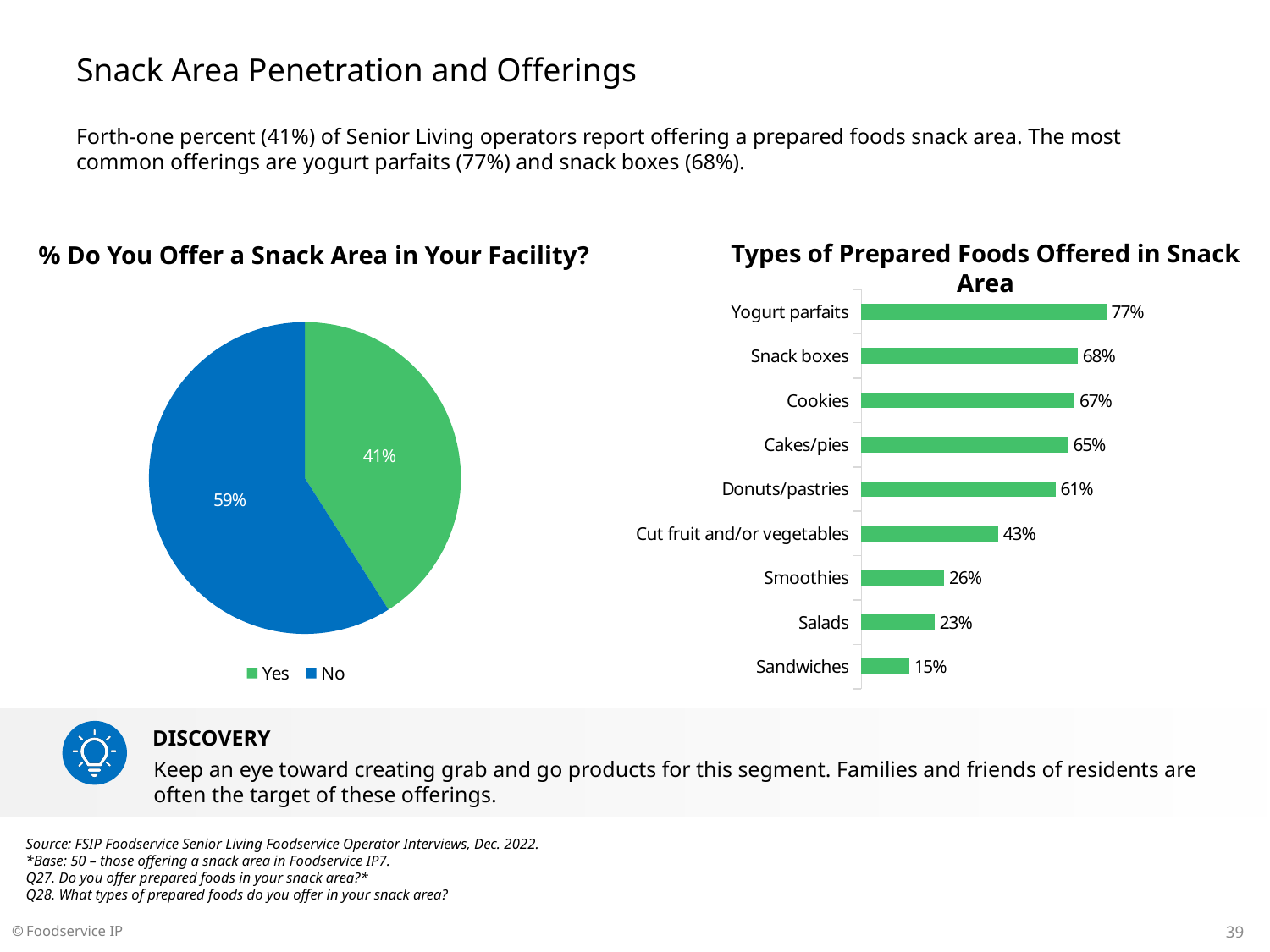
In the pie chart '% Do You Offer a Snack Area in Your Facility?', what share of respondents answered No? 59% In the chart 'Types of Prepared Foods Offered in Snack Area', which is larger, the value for Smoothies or the value for Salads? Smoothies In the chart 'Types of Prepared Foods Offered in Snack Area', which category has the highest value? Yogurt parfaits How many categories are shown in the chart 'Types of Prepared Foods Offered in Snack Area'? 9 In the chart 'Types of Prepared Foods Offered in Snack Area', what is the value for Snack boxes? 68% In the chart 'Types of Prepared Foods Offered in Snack Area', which category has the lowest value? Sandwiches In the chart 'Types of Prepared Foods Offered in Snack Area', what is the difference between the values for Yogurt parfaits and Sandwiches? 62% In the pie chart '% Do You Offer a Snack Area in Your Facility?', which slice is larger, Yes or No? No In the pie chart '% Do You Offer a Snack Area in Your Facility?', what share of respondents answered Yes? 41% In the pie chart '% Do You Offer a Snack Area in Your Facility?', how many entries does the legend list? 2 In the chart 'Types of Prepared Foods Offered in Snack Area', what is the value for Cut fruit and/or vegetables? 43% What kind of chart is 'Types of Prepared Foods Offered in Snack Area'? Bar chart